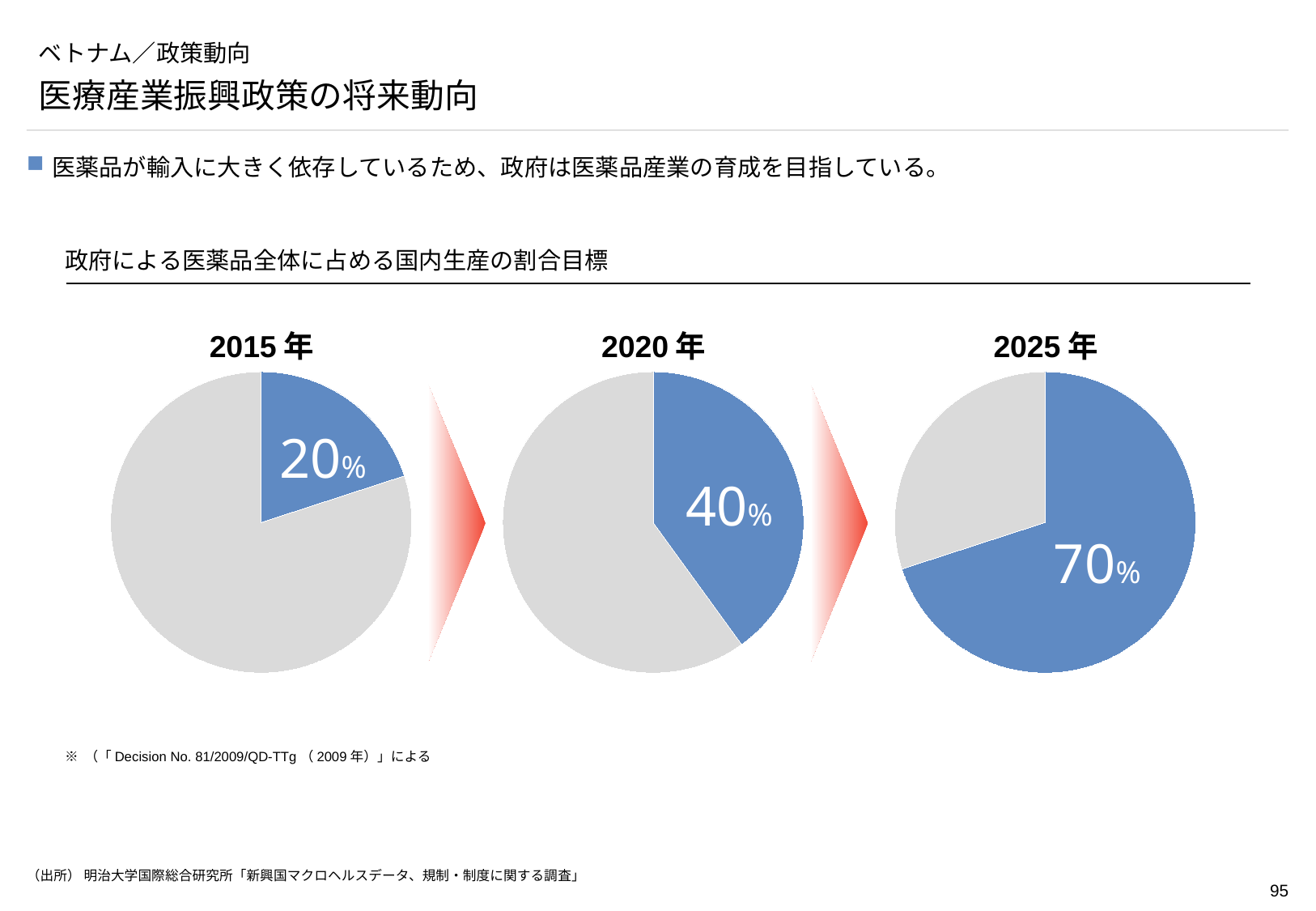
In the 2025年 pie chart, what share is shown for the blue slice? 70% How many pie charts are shown on the slide? 3 Is the blue slice larger in the 2020年 pie chart or the 2025年 pie chart? 2025年 Which pie chart shows the smallest blue slice? 2015年 Do the blue slice values rise or fall from the 2015年 pie chart to the 2025年 pie chart? Rise In the 2015年 pie chart, what share is shown for the blue slice? 20% Which pie chart shows the largest blue slice? 2025年 In the 2020年 pie chart, what share is shown for the blue slice? 40% What is the difference between the blue slice in the 2025年 pie chart and the blue slice in the 2015年 pie chart? 50% What is the title written above the three pie charts? 政府による医薬品全体に占める国内生産の割合目標 What is the difference between the blue slice in the 2020年 pie chart and the blue slice in the 2015年 pie chart? 20% What kind of charts are shown on the slide? Pie charts